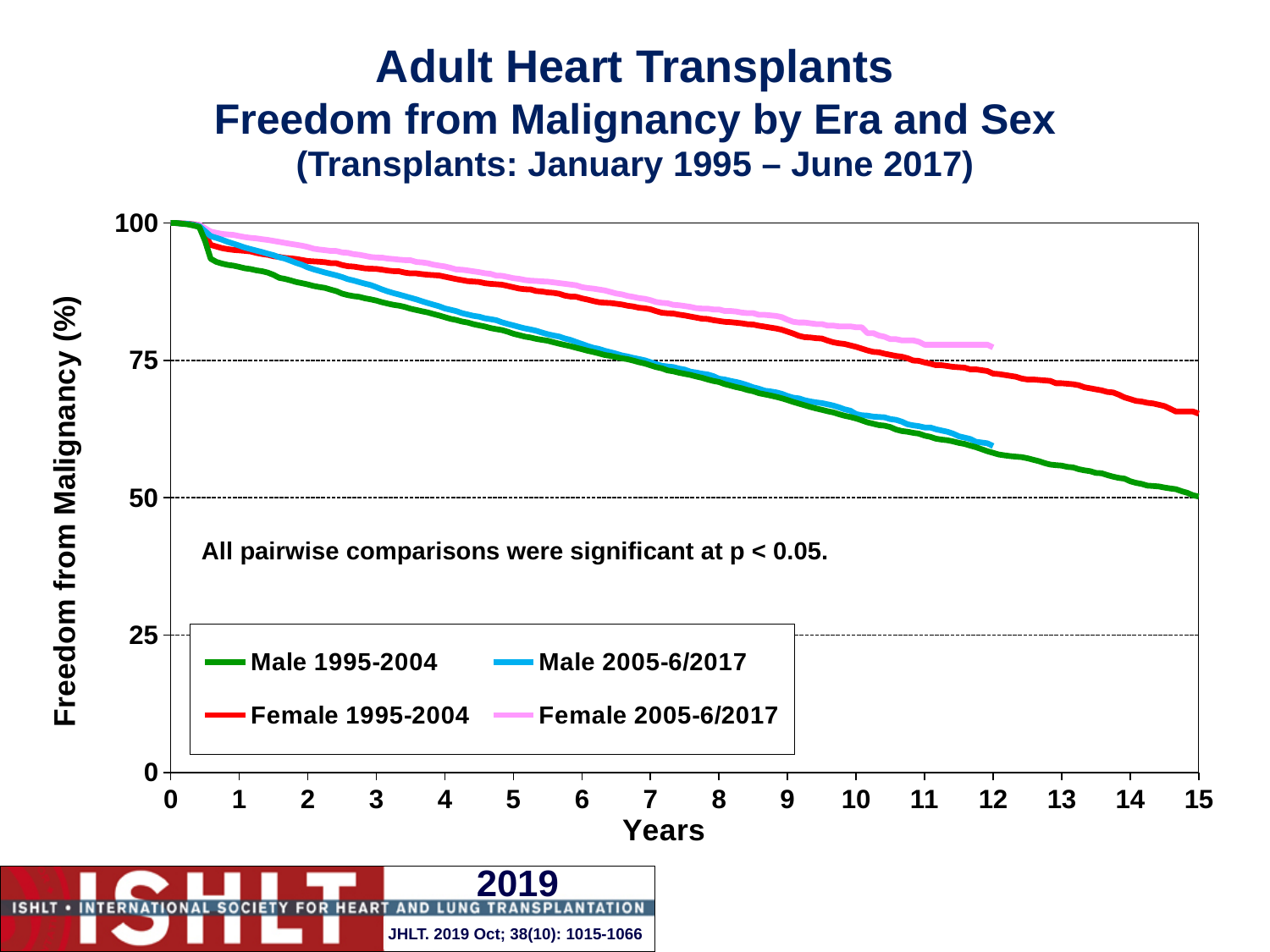
Is the value for Female 1995-2004 at year 15 greater or less than 75? less Is the value for Female 2005-6/2017 at year 5 greater or less than 75? greater How many series does the legend list? 4 Which series has the lowest freedom from malignancy at year 15? Male 1995-2004 Is the value for Male 1995-2004 at year 10 greater or less than 75? less At year 10, which is higher: Female 2005-6/2017 or Male 1995-2004? Female 2005-6/2017 What colour is the line for Male 2005-6/2017? Blue What is the label of the x axis? Years What kind of chart is shown on the slide? Line chart Do the values for Male 1995-2004 rise or fall as years increase? Fall Which series has the highest freedom from malignancy at year 10? Female 2005-6/2017